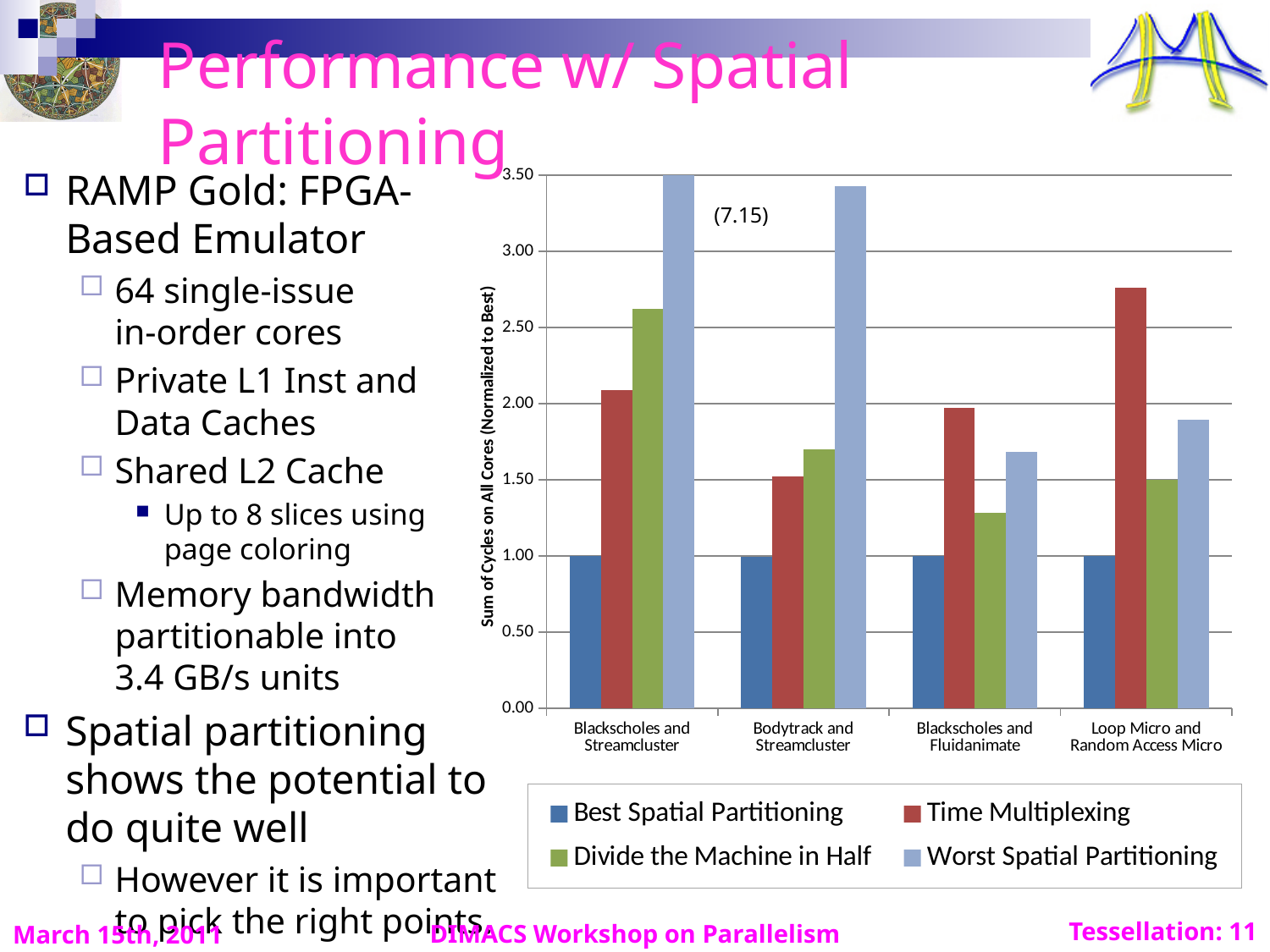
Which series has the lowest value in the Blackscholes and Fluidanimate category? Best Spatial Partitioning How many benchmark categories are shown on the x axis of the chart? 4 For Bodytrack and Streamcluster, which is larger: Time Multiplexing or Divide the Machine in Half? Divide the Machine in Half Which series has the highest value in the Loop Micro and Random Access Micro category? Time Multiplexing Is the value of Time Multiplexing for Loop Micro and Random Access Micro greater or less than 2.50? greater What is the title of the chart's y axis? Sum of Cycles on All Cores (Normalized to Best) What kind of chart is shown on the slide? bar chart Is the value of Divide the Machine in Half for Blackscholes and Fluidanimate greater or less than 1.50? less How many series does the chart's legend list? 4 What value is annotated for the Worst Spatial Partitioning bar in the Blackscholes and Streamcluster category? 7.15 Is the value of Worst Spatial Partitioning for Bodytrack and Streamcluster greater or less than 3.00? greater